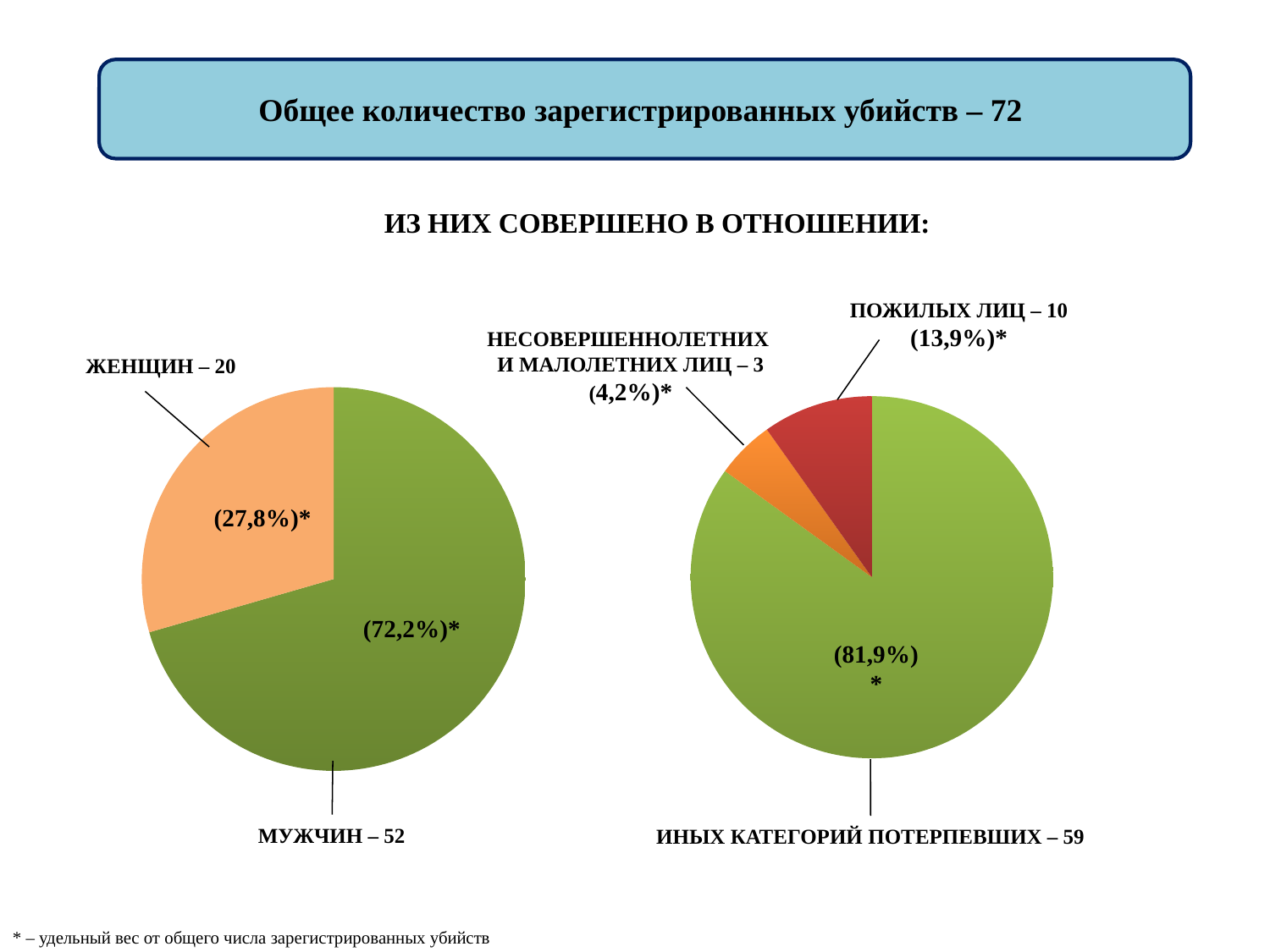
On the left pie chart, what share of the total do murders of men (МУЖЧИН) represent? 72,2% On the left pie chart, what is the difference between the number of murders of men (МУЖЧИН) and women (ЖЕНЩИН)? 32 On the right pie chart, how many murders were committed against minors and young children (НЕСОВЕРШЕННОЛЕТНИХ И МАЛОЛЕТНИХ ЛИЦ)? 3 On the right pie chart, how many categories are shown? 3 What is the total number of registered murders stated in the slide title? 72 On the right pie chart, which category has the smallest value? НЕСОВЕРШЕННОЛЕТНИХ И МАЛОЛЕТНИХ ЛИЦ On the left pie chart, which category has the larger value, ЖЕНЩИН or МУЖЧИН? МУЖЧИН On the left pie chart, what share of the total do murders of women (ЖЕНЩИН) represent? 27,8% What type of chart is used on the left side of the slide? Pie chart On the right pie chart, how many murders were committed against elderly persons (ПОЖИЛЫХ ЛИЦ)? 10 On the left pie chart, how many murders were committed against women (ЖЕНЩИН)? 20 On the right pie chart, what share of the total do murders of other categories of victims (ИНЫХ КАТЕГОРИЙ ПОТЕРПЕВШИХ) represent? 81,9%